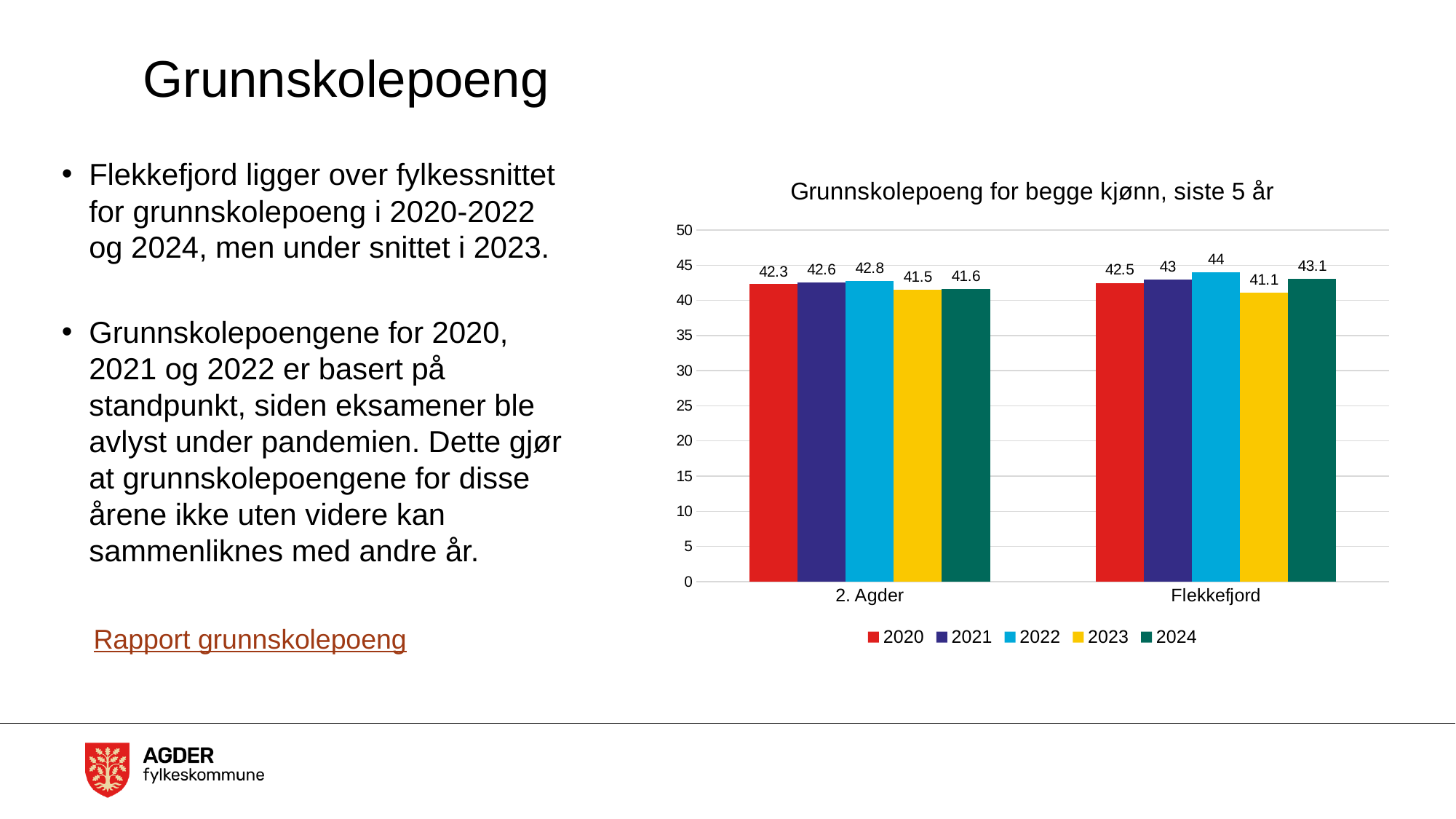
Is the value for Flekkefjord in 2022 greater or less than 40? greater Which year has the highest value for Flekkefjord? 2022 What is the value for 2. Agder in 2022? 42.8 How many categories are shown on the x axis? 2 What is the difference between Flekkefjord and 2. Agder in 2024? 1.5 How many series does the legend list? 5 What kind of chart is shown on the slide? bar chart Which year has the lowest value for 2. Agder? 2023 Which is larger in 2023, the value for 2. Agder or for Flekkefjord? 2. Agder What is the value for Flekkefjord in 2023? 41.1 What is the value for Flekkefjord in 2024? 43.1 What is the title of the chart? Grunnskolepoeng for begge kjønn, siste 5 år